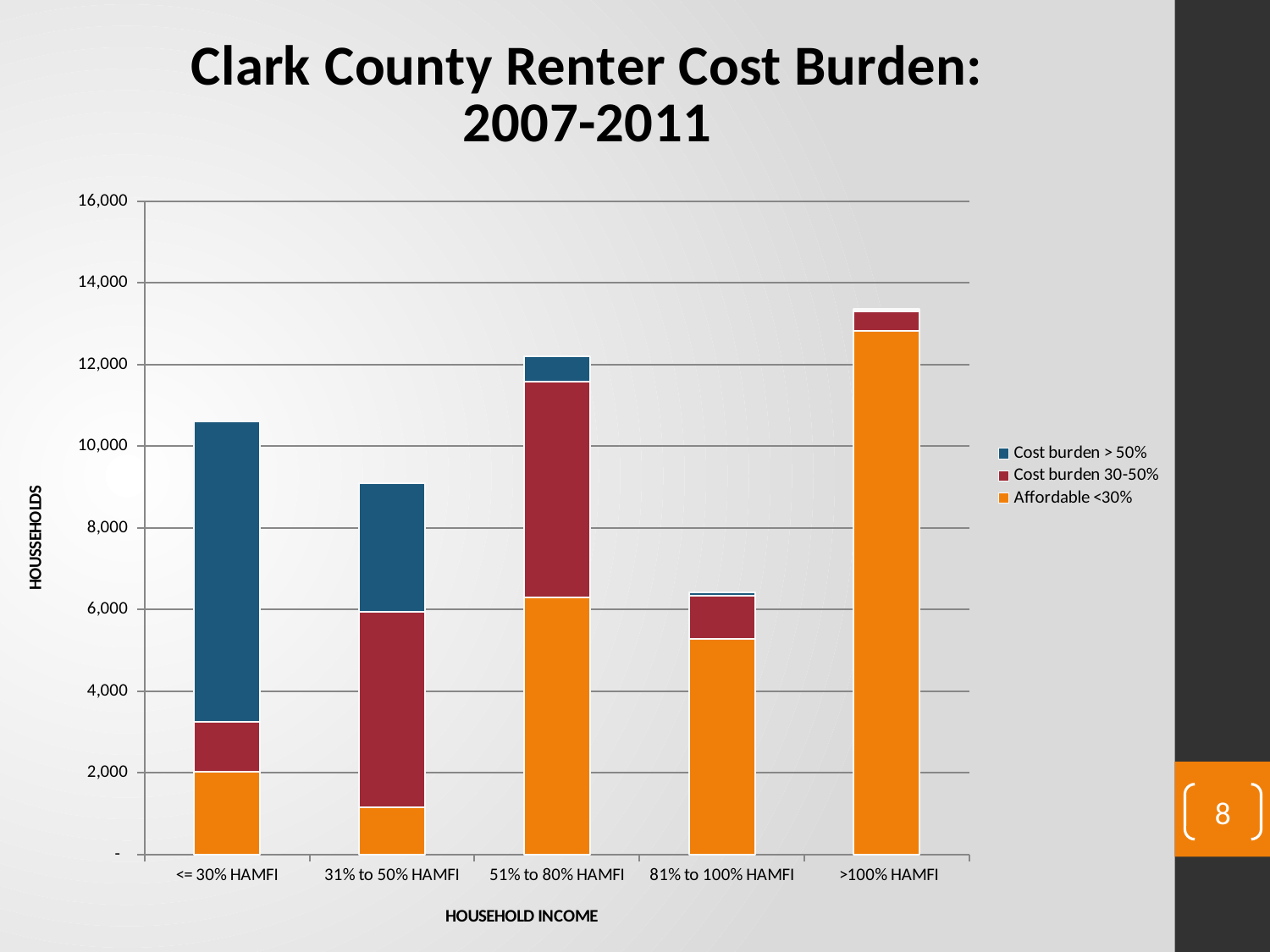
Is the total number of households for 31% to 50% HAMFI greater or less than 10,000? less How many household income categories are shown on the x axis? 5 Is the total number of households for 81% to 100% HAMFI greater or less than 8,000? less Is the Affordable <30% segment for >100% HAMFI greater or less than 12,000 households? greater Which household income category has the tallest stacked bar (most households in total)? >100% HAMFI What is the label of the y axis? HOUSSEHOLDS Which household income category has the shortest stacked bar (fewest households in total)? 81% to 100% HAMFI Which category has the larger total bar: 51% to 80% HAMFI or 31% to 50% HAMFI? 51% to 80% HAMFI What kind of chart is shown on the slide? stacked bar chart How many series does the legend list? 3 Which income category has the largest Cost burden > 50% segment? <= 30% HAMFI